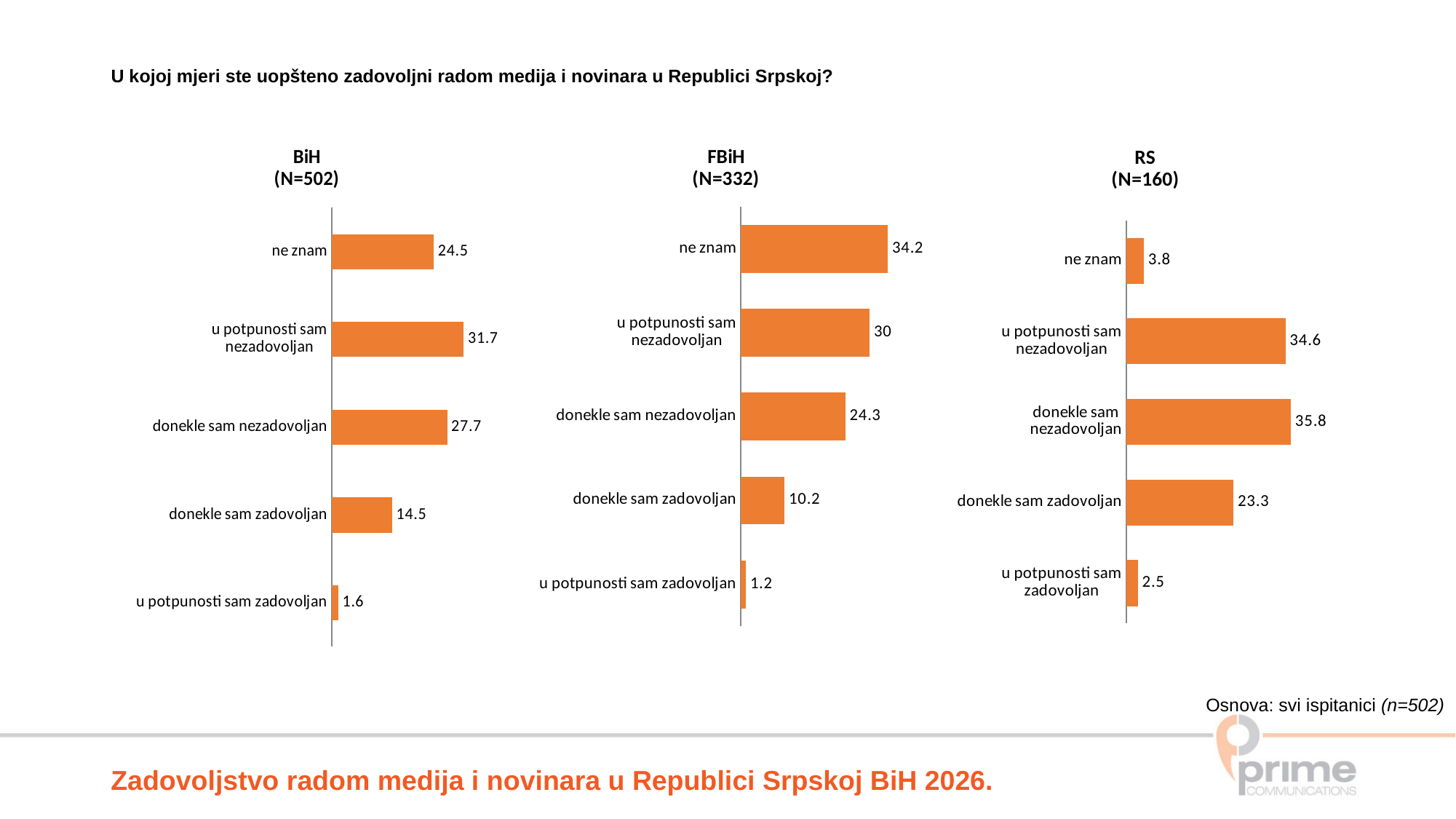
In the BiH (N=502) chart, which category has the lowest value? u potpunosti sam zadovoljan How many categories does the RS (N=160) chart show? 5 What type of chart is the BiH (N=502) chart? bar chart In the FBiH (N=332) chart, what is the difference between "donekle sam nezadovoljan" and "donekle sam zadovoljan"? 14.1 In the RS (N=160) chart, what is the value for "donekle sam zadovoljan"? 23.3 In the FBiH (N=332) chart, which category has the highest value? ne znam In the BiH (N=502) chart, what is the difference between "u potpunosti sam nezadovoljan" and "donekle sam nezadovoljan"? 4 In the RS (N=160) chart, which category has the highest value? donekle sam nezadovoljan In the FBiH (N=332) chart, what is the value for "ne znam"? 34.2 How many charts are shown on the slide? 3 Which is larger: the value for "ne znam" in the FBiH (N=332) chart or in the RS (N=160) chart? FBiH (N=332) In the BiH (N=502) chart, what is the value for "u potpunosti sam nezadovoljan"? 31.7